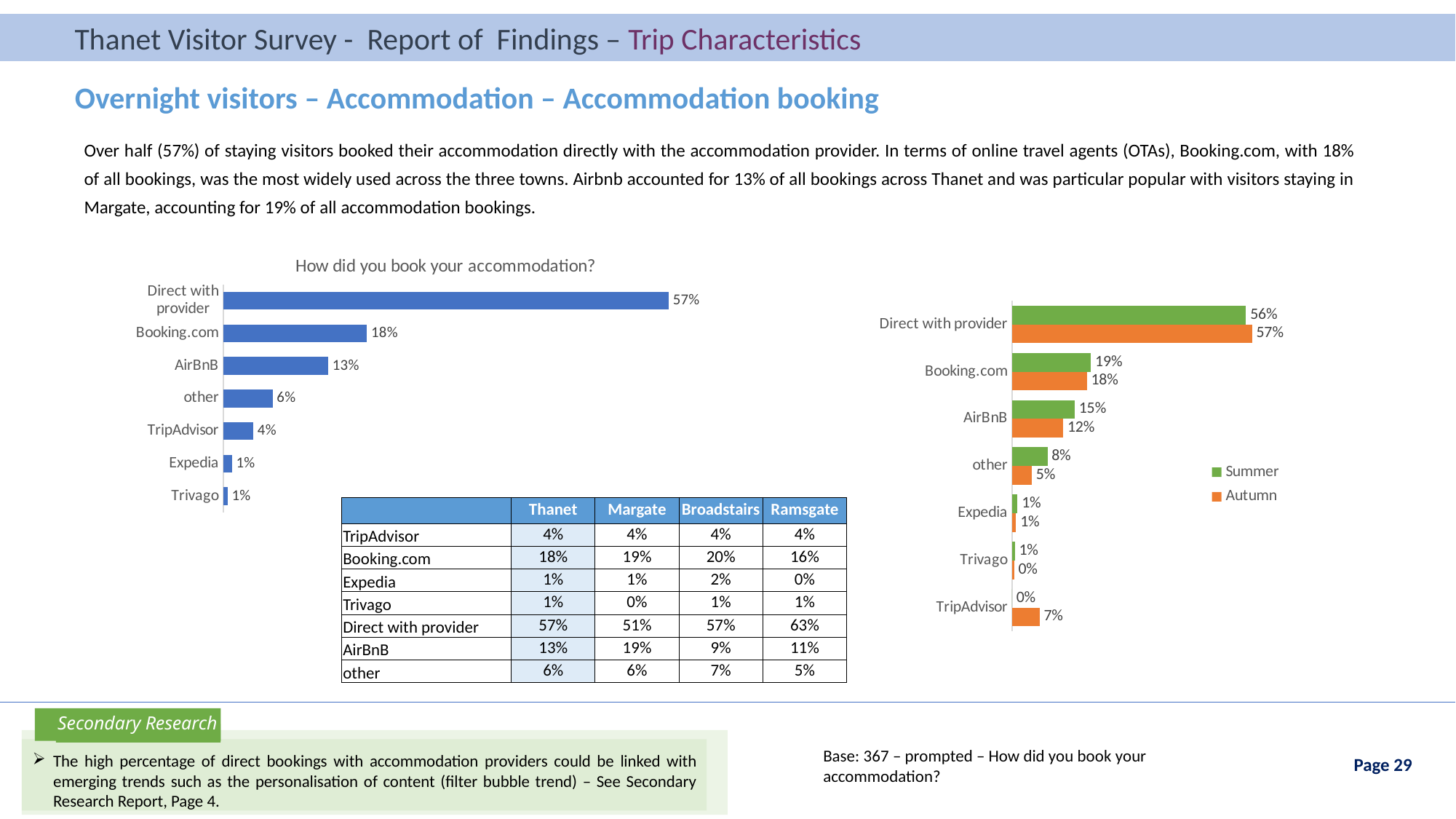
In the chart titled "How did you book your accommodation?", which is larger, the value for AirBnB or the value for other? AirBnB In the chart on the right of the slide, which series has the higher value for Direct with provider, Summer or Autumn? Autumn What kind of chart is the chart titled "How did you book your accommodation?"? Bar chart In the chart on the right of the slide, what colour are the Summer bars? Green In the chart titled "How did you book your accommodation?", how many categories are plotted? 7 In the chart titled "How did you book your accommodation?", which category has the highest value? Direct with provider In the chart titled "How did you book your accommodation?", what is the value for Booking.com? 18% In the chart on the right of the slide, what is the difference between the Summer and Autumn values for other? 3% In the chart on the right of the slide, what is the Summer value for AirBnB? 15% In the chart on the right of the slide, how many series does the legend list? 2 In the chart titled "How did you book your accommodation?", what is the difference between the values for Direct with provider and Booking.com? 39% In the chart on the right of the slide, what is the Autumn value for TripAdvisor? 7%